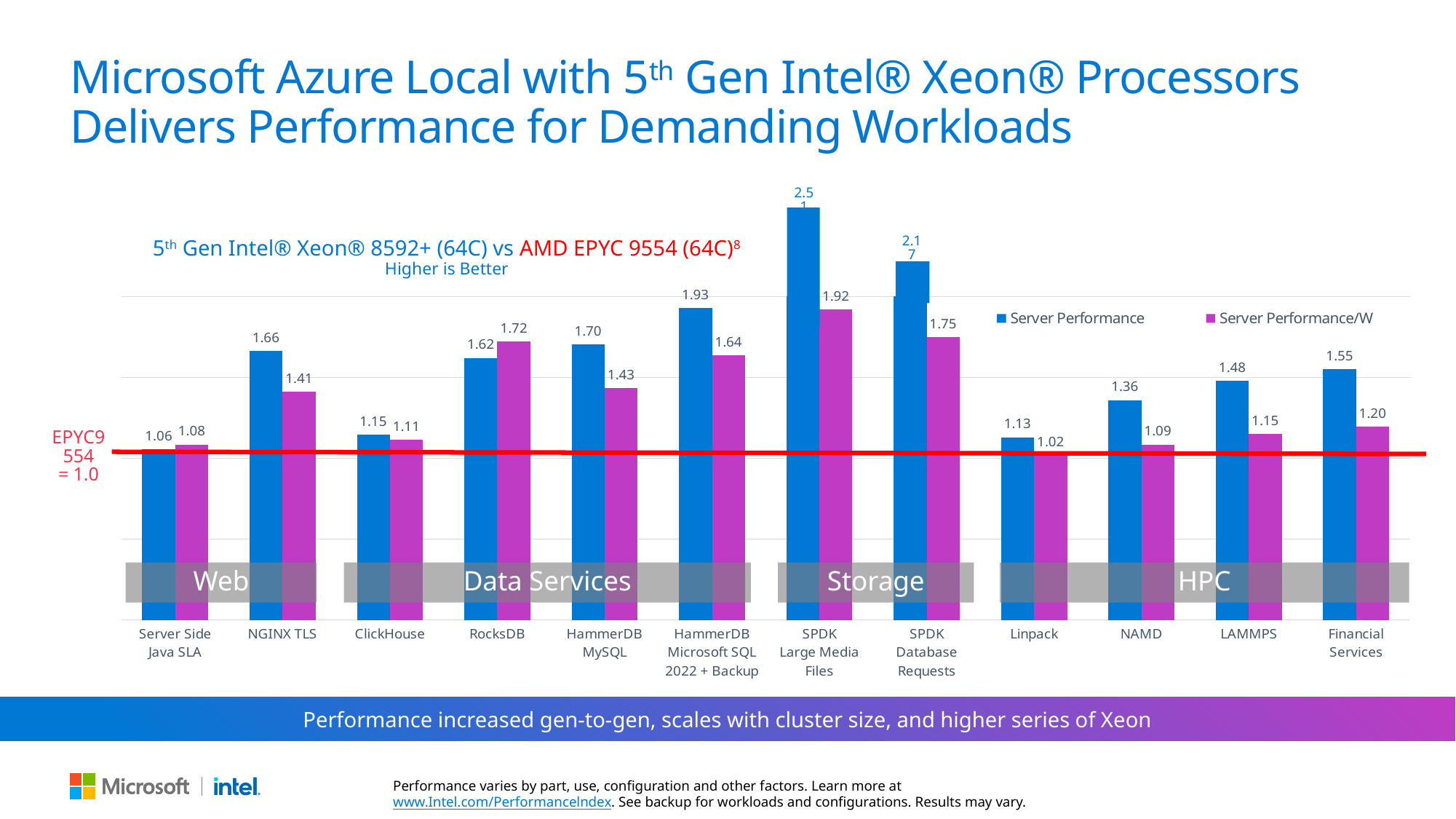
What is the difference between the Server Performance and Server Performance/W values for HammerDB MySQL? 0.27 Which workload has the lowest Server Performance/W value? Linpack How many series does the chart legend list? 2 How many workloads are shown on the x axis of the chart? 12 What kind of chart is shown on the slide? Bar chart For RocksDB, which is larger: Server Performance or Server Performance/W? Server Performance/W What is the Server Performance value for HammerDB Microsoft SQL 2022 + Backup? 1.93 What does the red horizontal line across the chart represent? EPYC 9554 = 1.0 What is the Server Performance value for NGINX TLS? 1.66 What is the Server Performance/W value for Linpack? 1.02 What is the Server Performance/W value for RocksDB? 1.72 Which workload has the highest Server Performance value? SPDK Large Media Files